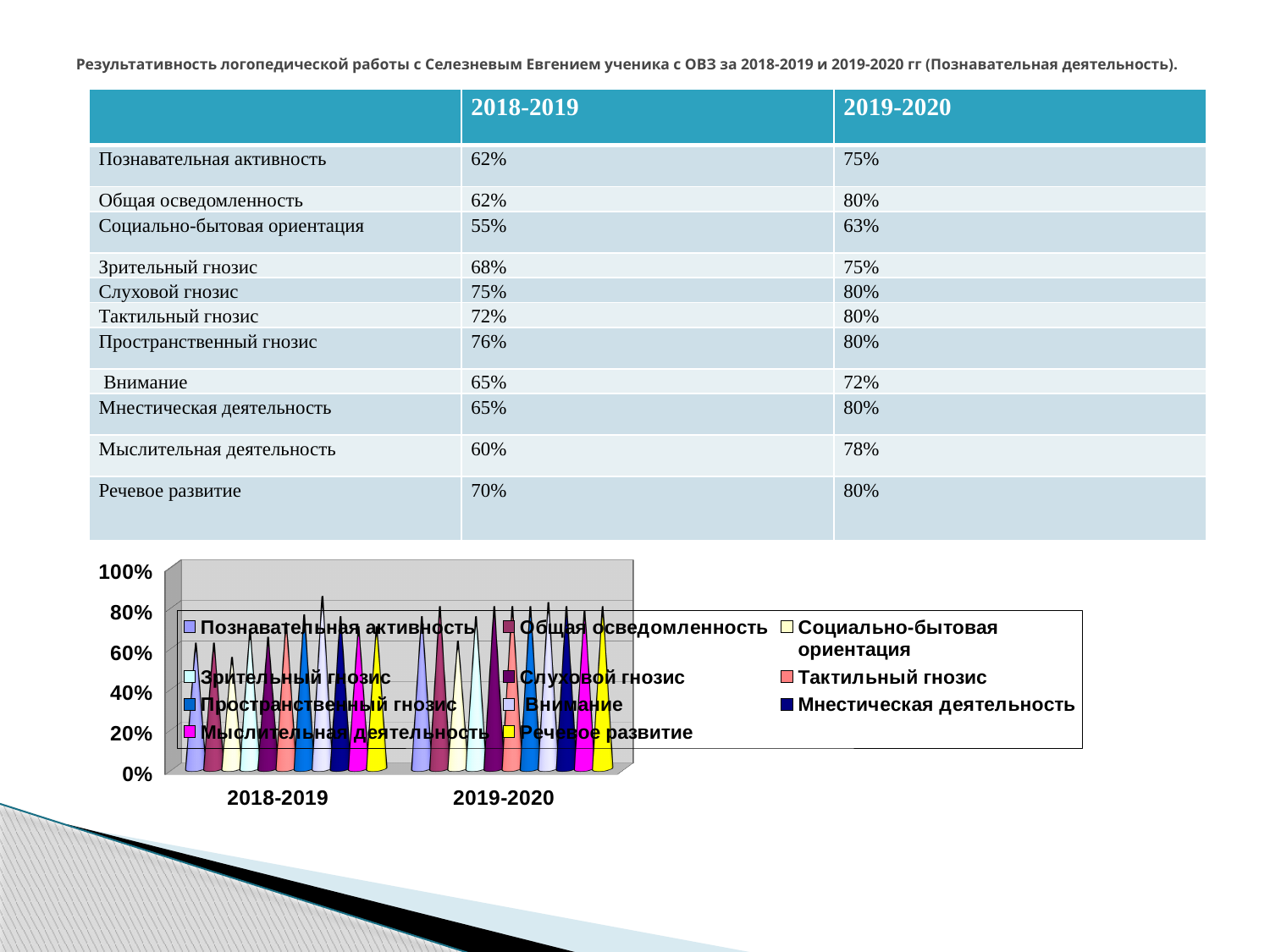
What are the two categories on the x axis of the chart? 2018-2019 and 2019-2020 What is the value for Мыслительная деятельность in 2019-2020? 78% Is the value for Социально-бытовая ориентация in 2018-2019 greater or less than 60%? less Which series has the lowest value in 2018-2019? Социально-бытовая ориентация How many categories are shown on the x axis of the chart? 2 What kind of chart is shown at the bottom of the slide? bar chart What is the value for Пространственный гнозис in 2018-2019? 76% Do the values for Познавательная активность rise or fall from 2018-2019 to 2019-2020? rise What is the difference between the 2019-2020 and 2018-2019 values for Речевое развитие? 10% Which is larger for Речевое развитие: the value in 2018-2019 or in 2019-2020? 2019-2020 How many series does the chart legend list? 11